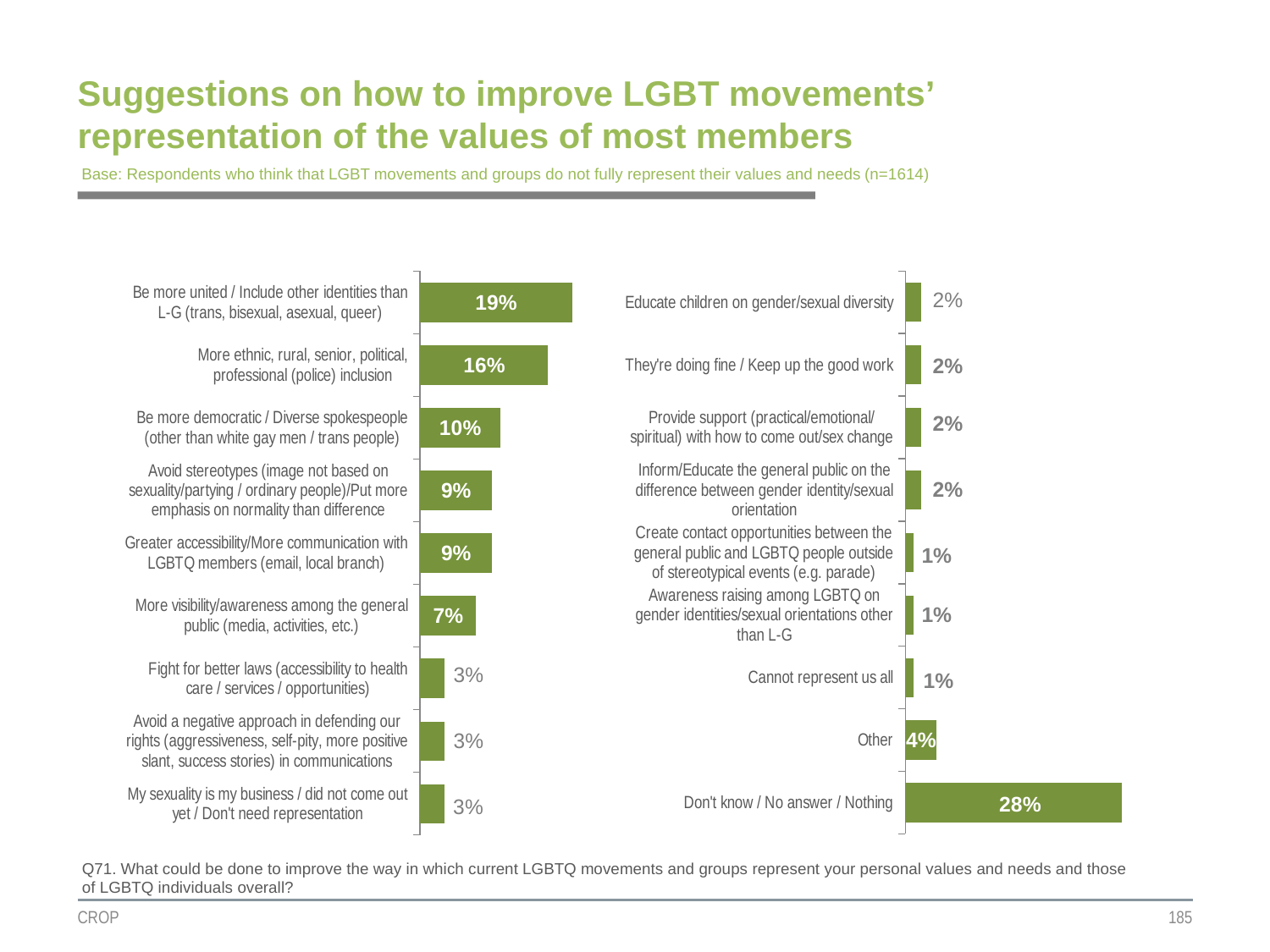
How many categories are shown in the left chart? 9 In the left chart, what is the difference between "Be more united / Include other identities than L-G" and "More ethnic, rural, senior, political, professional (police) inclusion"? 3% In the right chart, what is the value for "Other"? 4% In the right chart, which category has the highest value? Don't know / No answer / Nothing In the left chart, what is the value for "More visibility/awareness among the general public (media, activities, etc.)"? 7% In the left chart, which is larger: "Be more democratic / Diverse spokespeople" or "Fight for better laws"? Be more democratic / Diverse spokespeople In the left chart, which category has the highest value? Be more united / Include other identities than L-G (trans, bisexual, asexual, queer) In the right chart, what is the value for "Don't know / No answer / Nothing"? 28% What type of chart is used on this slide? Bar chart In the left chart, what is the value for "More ethnic, rural, senior, political, professional (police) inclusion"? 16% In the left chart, what is the value for "Be more united / Include other identities than L-G (trans, bisexual, asexual, queer)"? 19% How many categories are shown in the right chart? 9